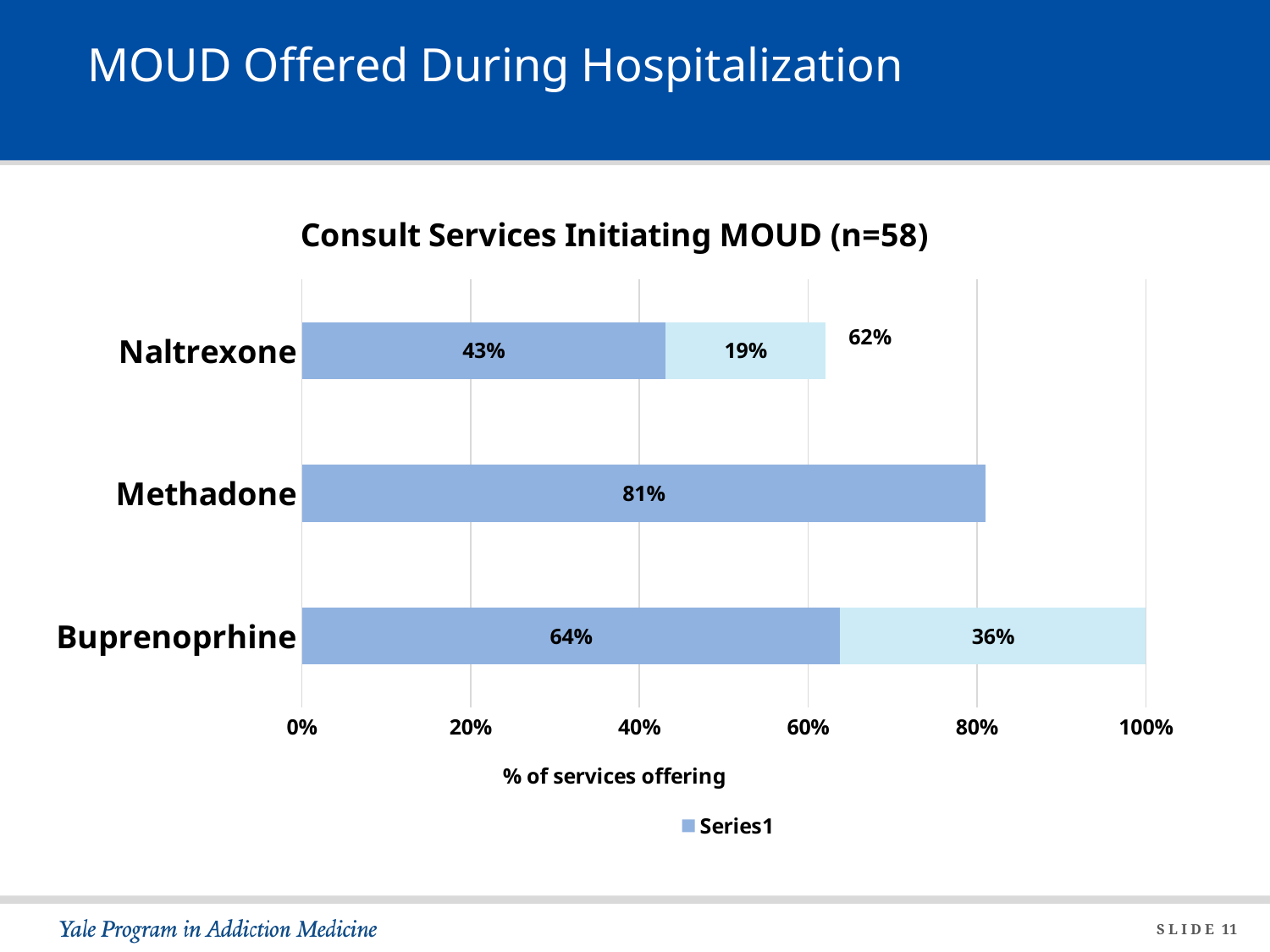
What is the value of the darker blue segment for Naltrexone? 43% What kind of chart is shown on the slide? Stacked bar chart What is the total of the stacked bar for Naltrexone? 62% What is the value of the lighter blue segment for Naltrexone? 19% How many categories are shown on the chart? 3 Which category has the highest value for the darker blue segment? Methadone What is the difference between the darker blue segment values for Methadone and Buprenoprhine? 17% What is the title of the chart? Consult Services Initiating MOUD (n=58) Which is larger: the darker blue segment for Buprenoprhine or the darker blue segment for Naltrexone? Buprenoprhine Which category has the lowest value for the darker blue segment? Naltrexone What is the value of the lighter blue segment for Buprenoprhine? 36% What is the value of the darker blue segment for Methadone? 81%